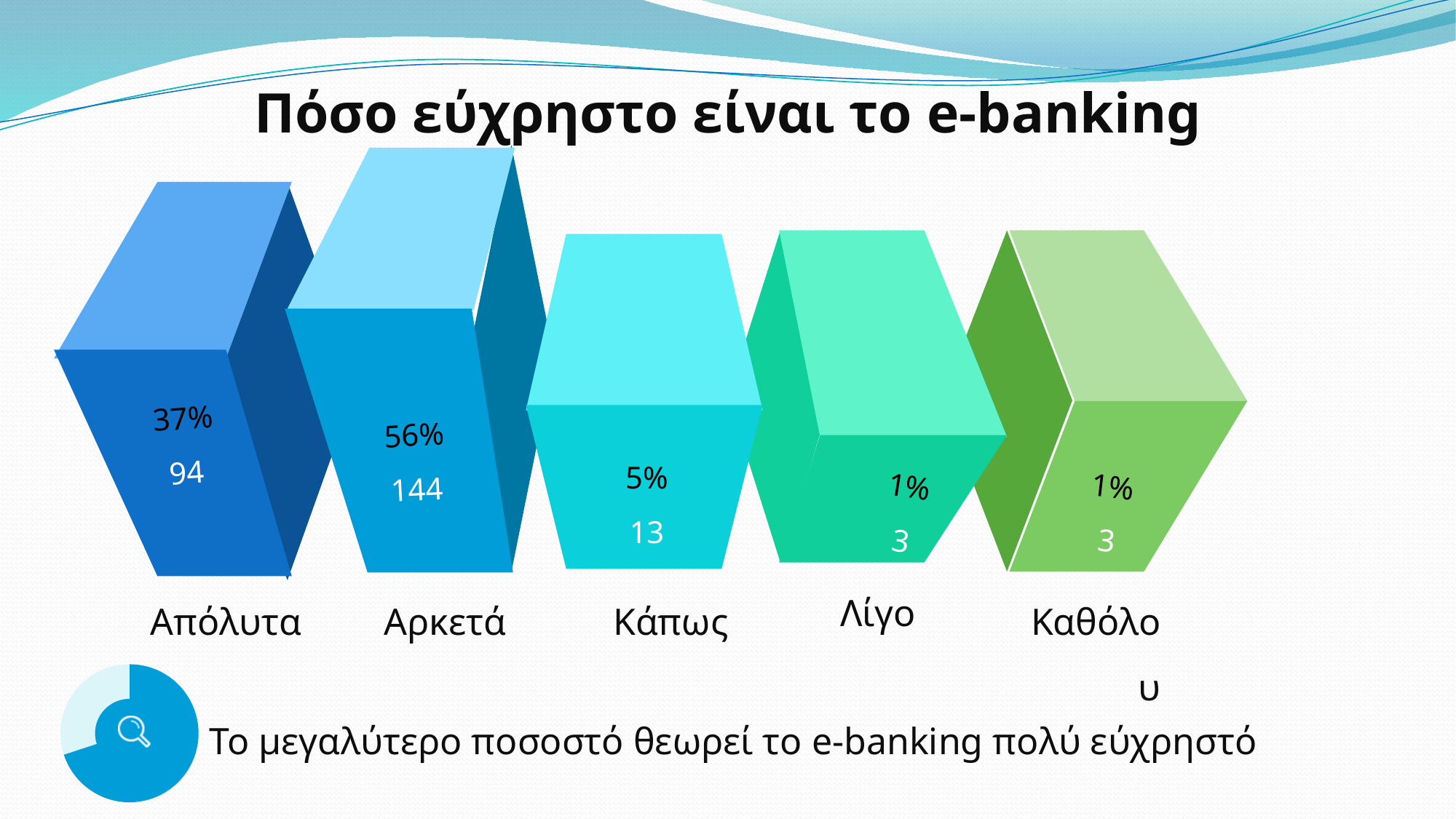
Which is larger, the count for Απόλυτα or the count for Κάπως? Απόλυτα What is the difference between the counts for Αρκετά and Απόλυτα? 50 What is the title of the chart? Πόσο εύχρηστο είναι το e-banking What is the difference in percentage points between Απόλυτα and Κάπως? 32 Which category has the highest value? Αρκετά What percentage is shown for the category Λίγο? 1% What kind of chart is shown on the slide? Bar chart How many categories are shown in the chart? 5 What percentage is shown for the category Απόλυτα? 37% What is the count shown for the category Κάπως? 13 What is the total count across all five categories? 257 What is the count shown for the category Αρκετά? 144